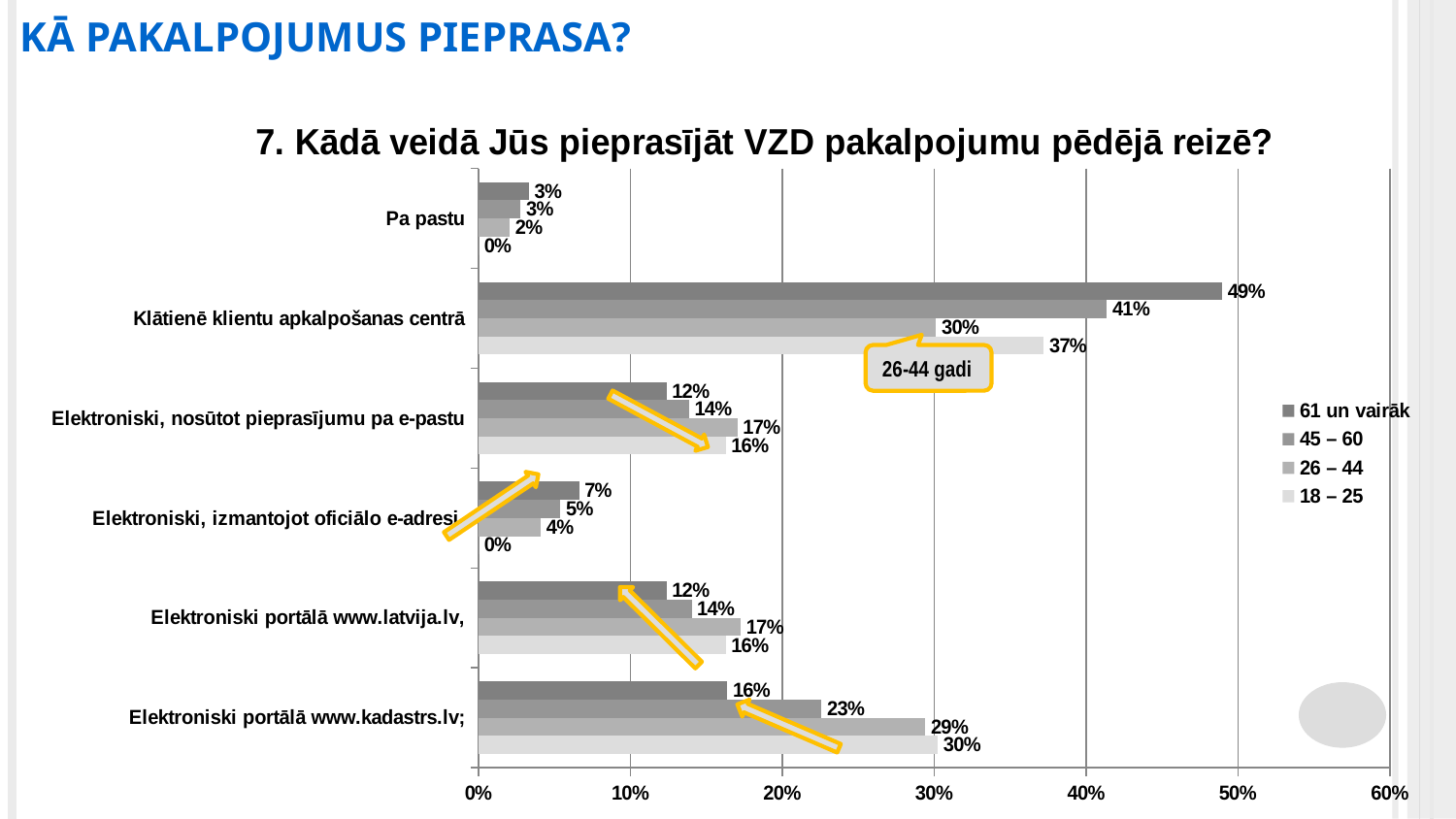
Which series has the lowest value in the 'Pa pastu' category? 18 – 25 What is the difference between the '61 un vairāk' and '26 – 44' values in the 'Klātienē klientu apkalpošanas centrā' category? 19% What is the value for the '26 – 44' series in the 'Elektroniski, izmantojot oficiālo e-adresi' category? 4% How many series does the legend list? 4 In the 'Elektroniski portālā www.kadastrs.lv;' category, which is larger: the '61 un vairāk' value or the '45 – 60' value? 45 – 60 What is the difference between the '18 – 25' and '61 un vairāk' values in the 'Elektroniski portālā www.kadastrs.lv;' category? 14% What is the value for the '61 un vairāk' series in the 'Klātienē klientu apkalpošanas centrā' category? 49% What kind of chart is shown on the slide? bar chart Which category has the highest value for the '45 – 60' series? Klātienē klientu apkalpošanas centrā How many categories are shown on the chart? 6 What is the title of the chart? 7. Kādā veidā Jūs pieprasījāt VZD pakalpojumu pēdējā reizē? What is the value for the '18 – 25' series in the 'Elektroniski portālā www.kadastrs.lv;' category? 30%